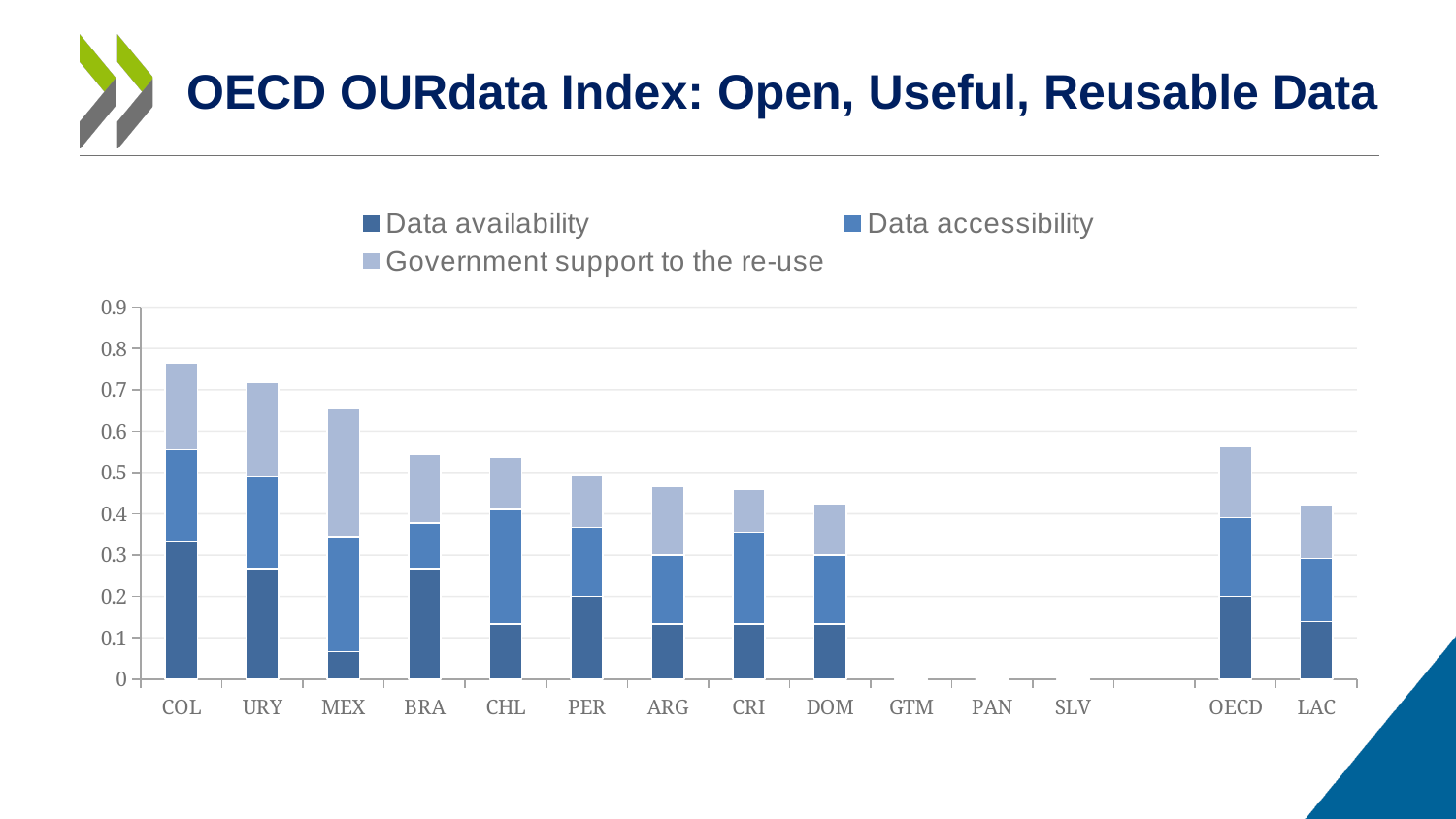
Is the total value for DOM greater or less than 0.5? less Which three country categories on the x axis have no bars plotted? GTM, PAN, SLV How many series does the legend list? 3 Do the total bar heights rise or fall from COL to DOM along the x axis? fall Is the total value for COL greater or less than 0.7? greater Which has the larger total bar, OECD or LAC? OECD Is the total value for MEX greater or less than 0.6? greater Which category has the highest total bar? COL Which has the larger total bar, MEX or BRA? MEX What kind of chart is shown on the slide? Stacked bar chart Which legend entry is shown in the lightest shade of blue? Government support to the re-use